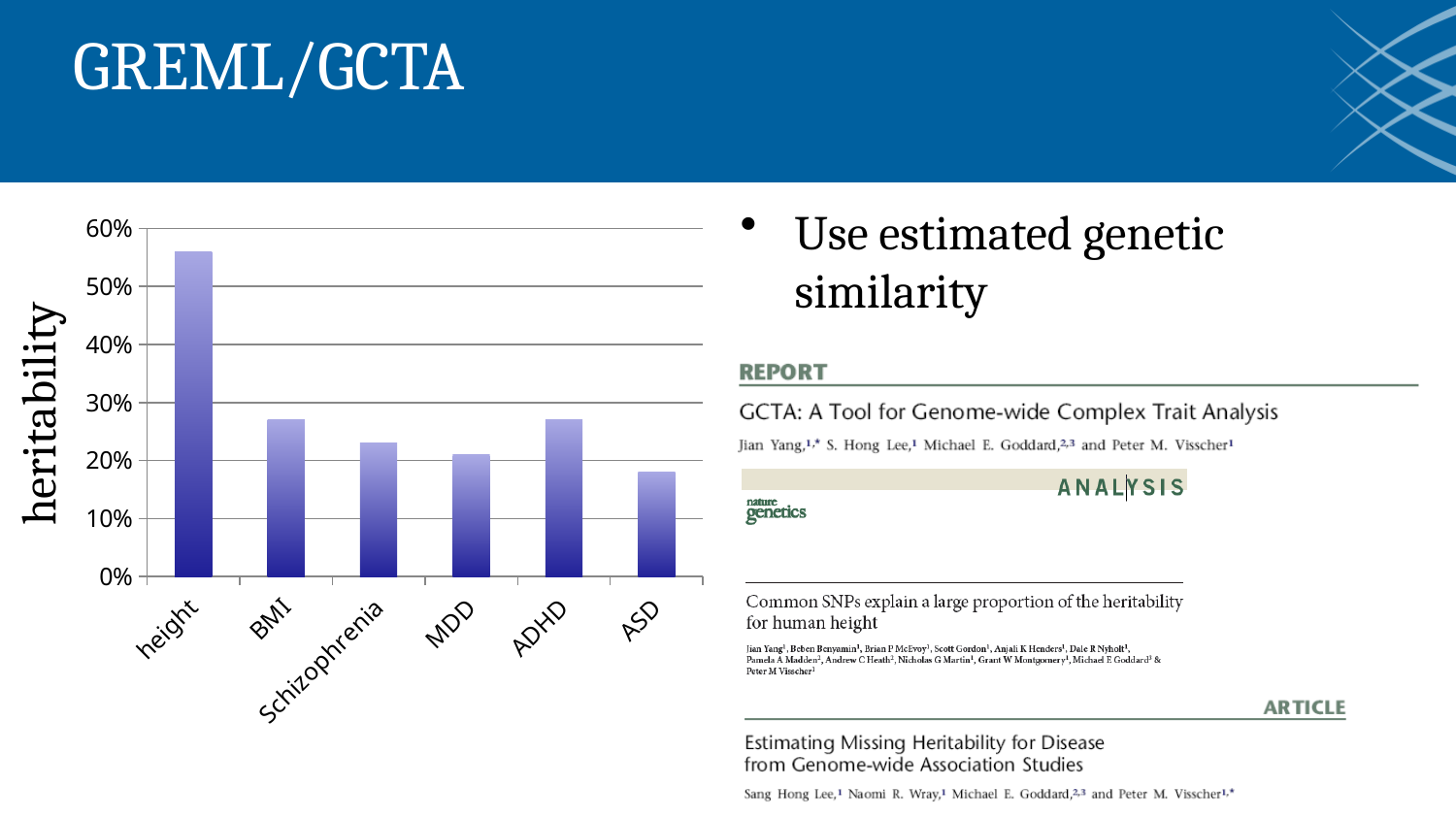
Which category has the lowest heritability in the bar chart? ASD What is the label on the vertical axis of the bar chart? heritability Is the heritability value for BMI greater or less than 30%? less Is the heritability value for Schizophrenia greater or less than 20%? greater Is the heritability value for height greater or less than 50%? greater How many categories are plotted in the bar chart? 6 Which has a higher heritability, height or BMI? height What kind of chart is shown on the slide? bar chart Which category has the highest heritability in the bar chart? height Which has a higher heritability, Schizophrenia or ASD? Schizophrenia